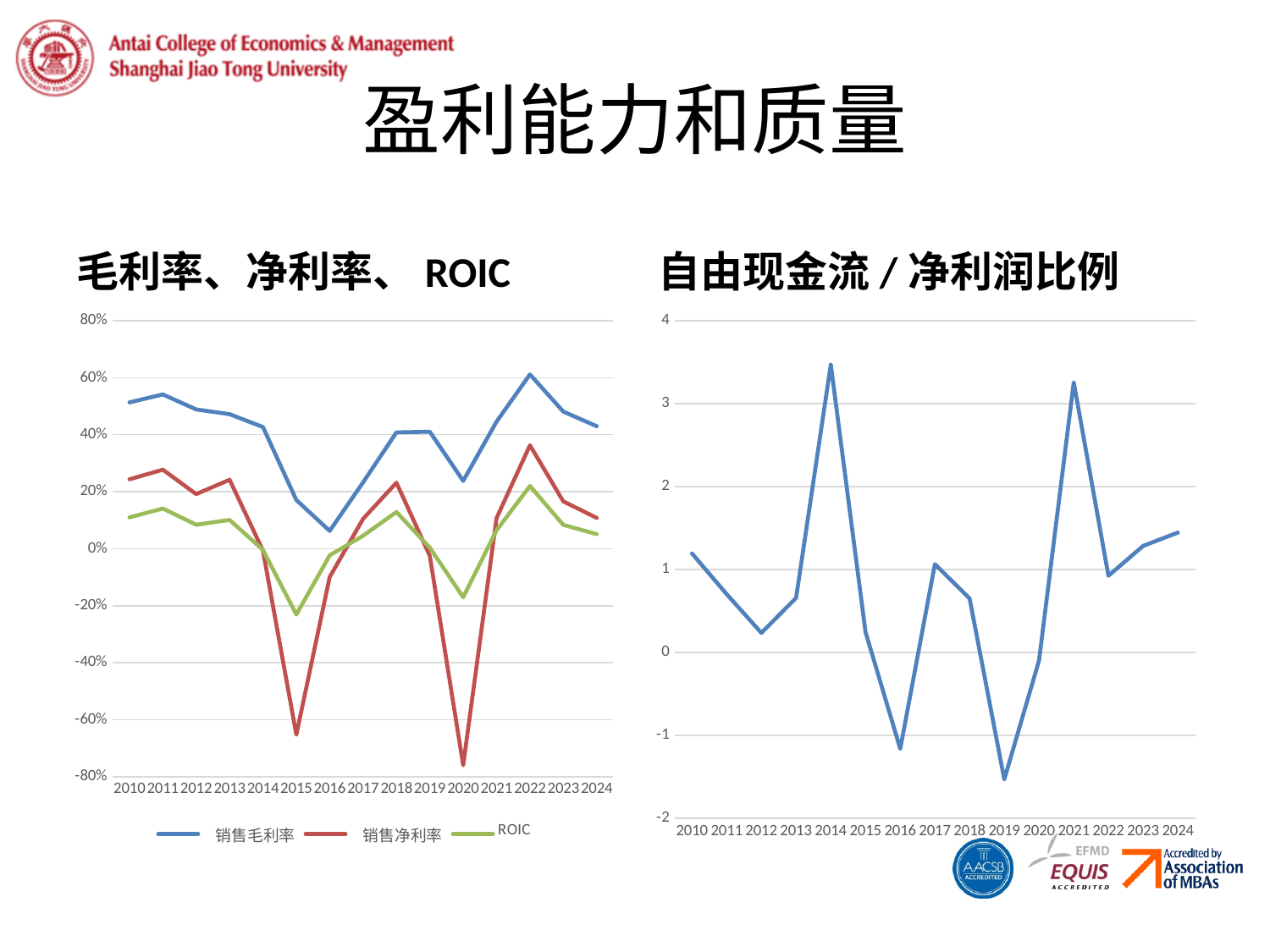
In the left chart (毛利率、净利率、ROIC), how many years are plotted on the x axis? 15 In the left chart (毛利率、净利率、ROIC), how many series does the legend list? 3 What type of chart is the right chart titled 自由现金流 / 净利润比例? Line chart In the left chart (毛利率、净利率、ROIC), what are the three series named in the legend? 销售毛利率, 销售净利率, ROIC In the left chart (毛利率、净利率、ROIC), is the 销售毛利率 value for 2016 greater or less than 20%? less In the left chart (毛利率、净利率、ROIC), in which year is 销售毛利率 highest? 2022 In the left chart (毛利率、净利率、ROIC), in which year is 销售净利率 lowest? 2020 In the right chart (自由现金流 / 净利润比例), in which year is the value highest? 2014 In the right chart (自由现金流 / 净利润比例), is the value for 2019 greater or less than -1? less In the left chart (毛利率、净利率、ROIC), which is larger: 销售毛利率 in 2010 or in 2024? 2010 In the left chart (毛利率、净利率、ROIC), is the 销售净利率 value for 2020 greater or less than -60%? less What type of chart is the left chart titled 毛利率、净利率、ROIC? Line chart